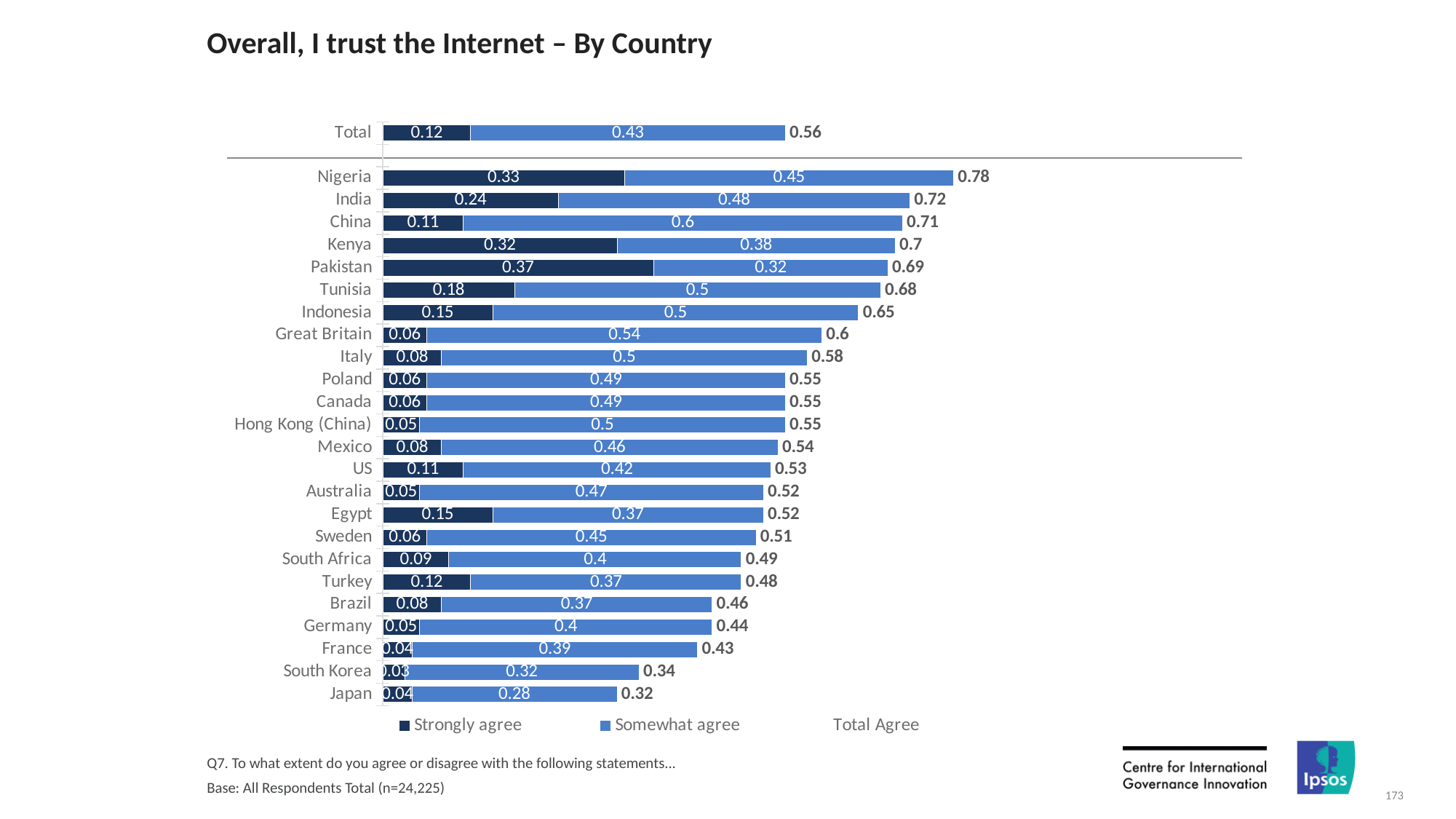
What is the Strongly agree value for Pakistan? 0.37 How many entries does the legend list? 3 What kind of chart is shown on the slide? Stacked bar chart What is the Somewhat agree value for the Total row? 0.43 What is the difference between the Total Agree values for Nigeria and Japan? 0.46 How many countries are listed on the chart, excluding the Total row? 24 What is the Somewhat agree value for China? 0.6 Which has a larger Strongly agree value, India or Kenya? Kenya What is the Total Agree value for Tunisia? 0.68 Which country has the highest Total Agree value? Nigeria Which country has the highest Strongly agree value? Pakistan Which country has the lowest Total Agree value? Japan